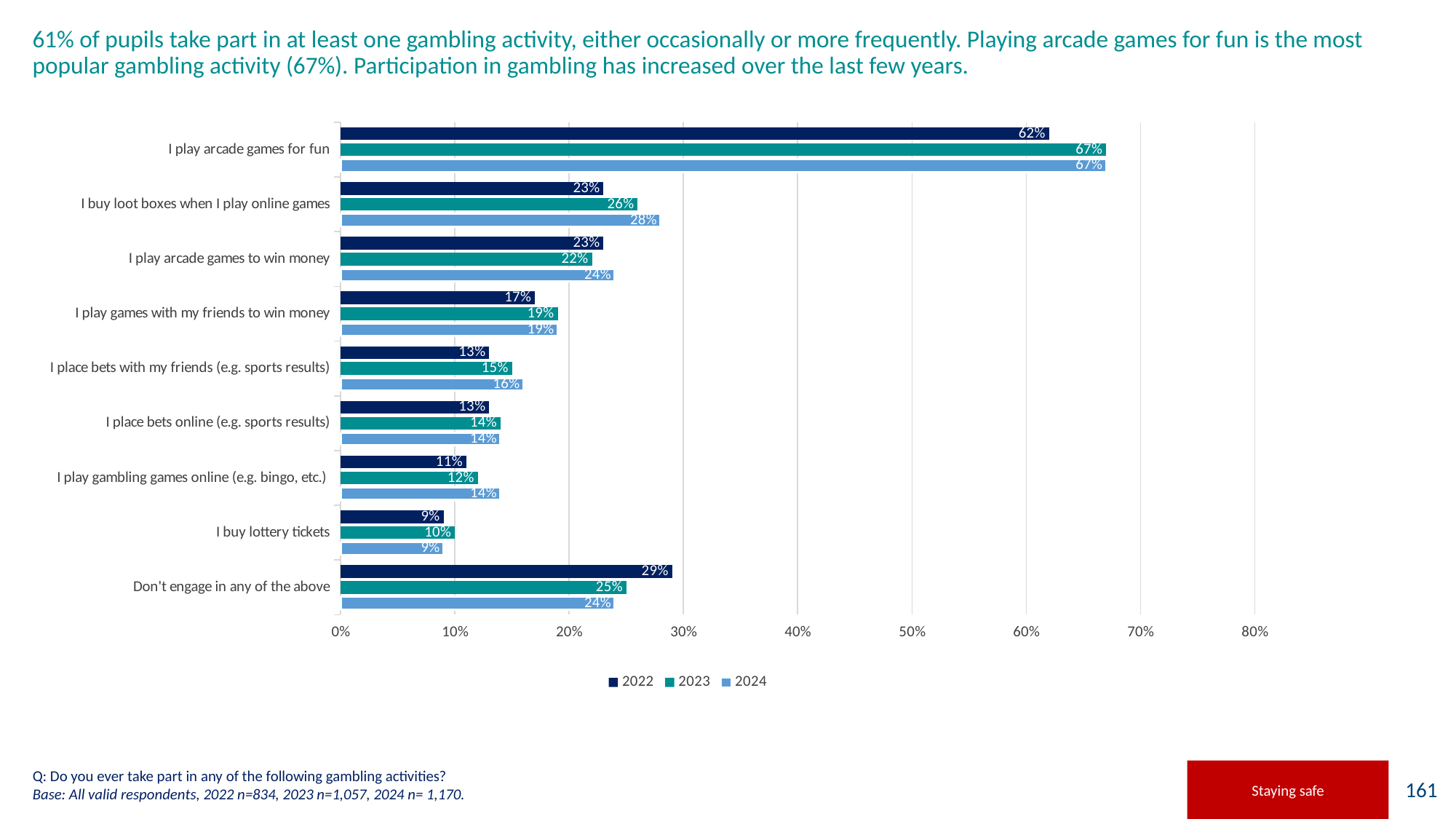
What percentage of pupils said they don't engage in any of the above in 2023? 25% Which years are listed in the chart legend? 2022, 2023, 2024 How many series does the legend list? 3 What percentage of pupils said they play arcade games for fun in 2024? 67% How many activity categories are shown on the chart? 9 Which activity has the highest value in 2024? I play arcade games for fun What kind of chart is shown on the slide? Bar chart What was the value for 'I buy loot boxes when I play online games' in 2022? 23% Did the value for 'I play gambling games online (e.g. bingo, etc.)' rise or fall from 2022 to 2024? Rise What is the difference between the 2024 and 2022 values for 'I buy loot boxes when I play online games'? 5% Which activity has the lowest value in 2022? I buy lottery tickets Which is larger: the 2022 value for 'Don't engage in any of the above' or the 2024 value for 'Don't engage in any of the above'? 2022